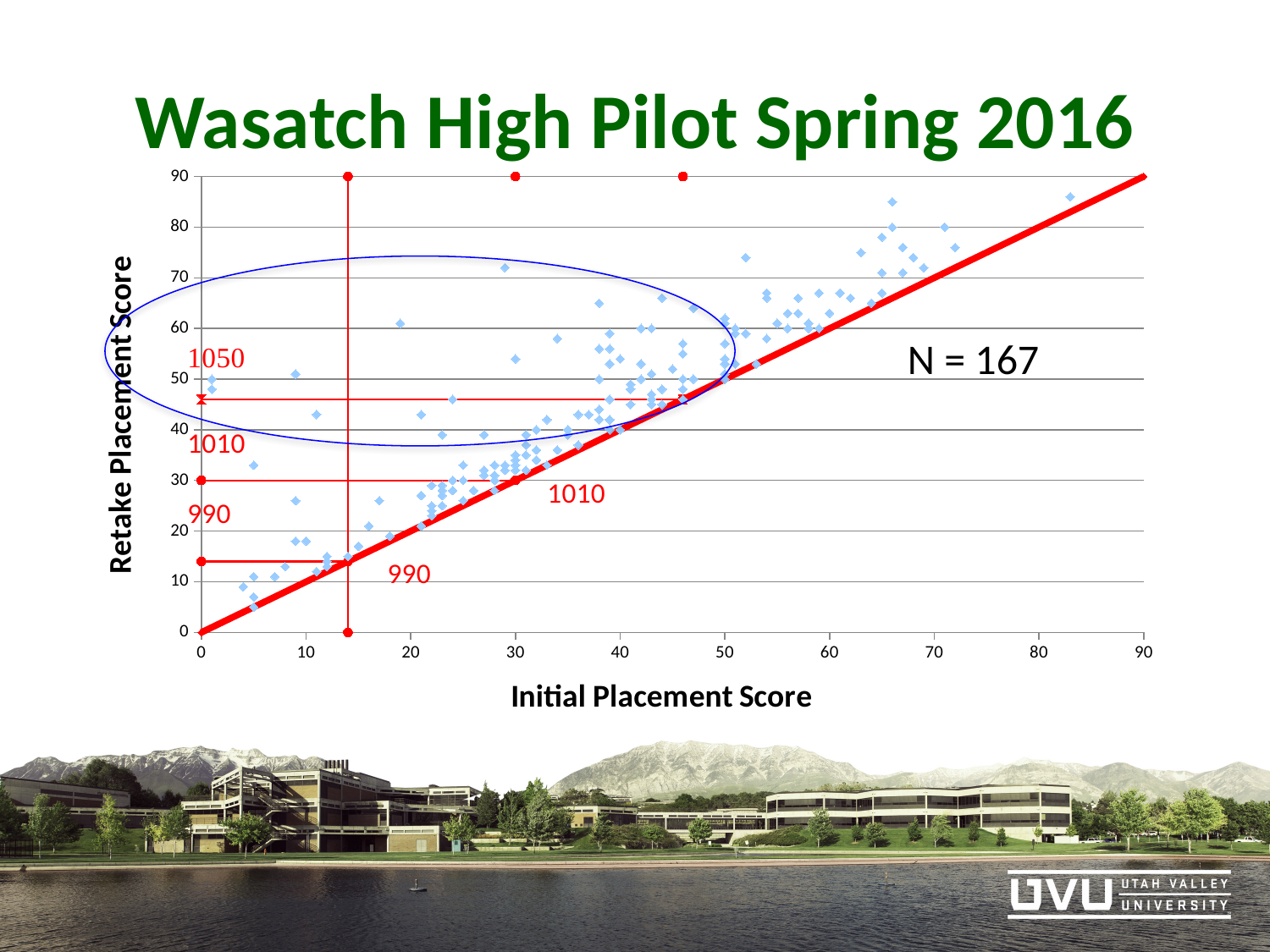
What is the title of the vertical axis of the chart? Retake Placement Score What kind of chart is shown on the slide? scatter chart Is the initial placement score of the point with the highest initial placement score greater or less than 80? greater Do retake placement scores generally rise or fall as initial placement scores increase along the x axis? rise Is the retake placement score of the point with the highest initial placement score greater or less than 80? greater According to the text printed on the chart, how many students (N) are plotted? 167 What is the title of the chart? Wasatch High Pilot Spring 2016